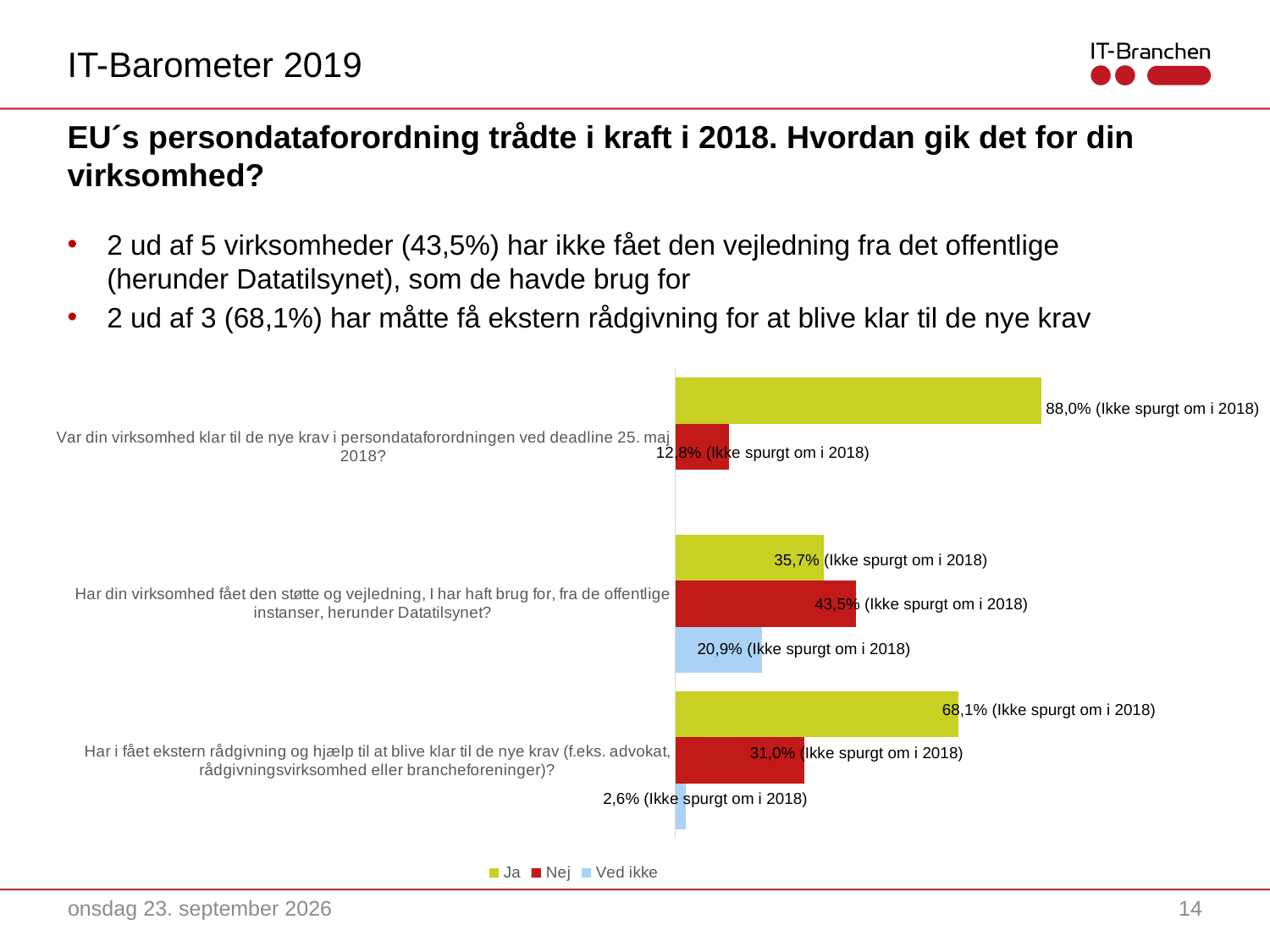
What is the 'Ved ikke' value for 'Har i fået ekstern rådgivning og hjælp til at blive klar til de nye krav'? 2,6% Which question has the lowest 'Ved ikke' value among those with a 'Ved ikke' label? Har i fået ekstern rådgivning og hjælp til at blive klar til de nye krav What is the 'Nej' value for 'Har din virksomhed fået den støtte og vejledning, I har haft brug for, fra de offentlige instanser, herunder Datatilsynet?' 43,5% How many series does the legend list? 3 How many question categories are plotted on the chart? 3 What is the 'Ja' value for 'Var din virksomhed klar til de nye krav i persondataforordningen ved deadline 25. maj 2018?' 88,0% For 'Har din virksomhed fået den støtte og vejledning, I har haft brug for, fra de offentlige instanser, herunder Datatilsynet?', is the 'Ja' or the 'Nej' value larger? Nej Which question has the highest 'Ja' value? Var din virksomhed klar til de nye krav i persondataforordningen ved deadline 25. maj 2018? What are the series names listed in the legend? Ja, Nej, Ved ikke What kind of chart is shown on the slide? Bar chart What is the difference between the 'Ja' and 'Nej' values for 'Har i fået ekstern rådgivning og hjælp til at blive klar til de nye krav'? 37,1% What is the 'Nej' value for 'Var din virksomhed klar til de nye krav i persondataforordningen ved deadline 25. maj 2018?' 12,8%